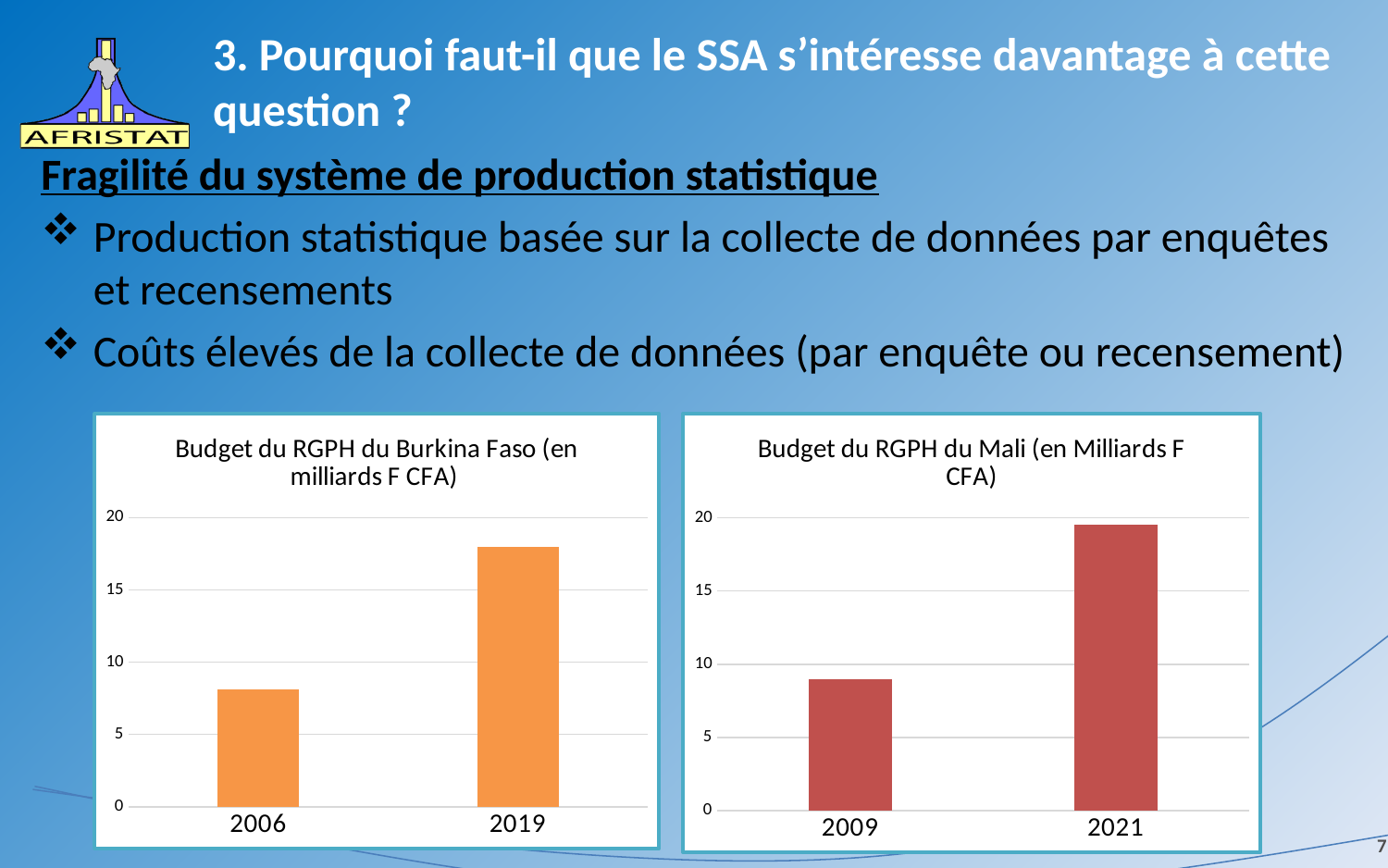
In the chart titled "Budget du RGPH du Mali (en Milliards F CFA)", which year has the highest value? 2021 In the chart titled "Budget du RGPH du Burkina Faso (en milliards F CFA)", is the value for 2019 greater or less than 15? greater What is the title of the chart on the left of the slide? Budget du RGPH du Burkina Faso (en milliards F CFA) In the chart titled "Budget du RGPH du Mali (en Milliards F CFA)", do the values rise or fall from 2009 to 2021? Rise In the chart titled "Budget du RGPH du Mali (en Milliards F CFA)", which is larger, the value for 2009 or the value for 2021? 2021 How many categories are shown in the chart titled "Budget du RGPH du Burkina Faso (en milliards F CFA)"? 2 In the chart titled "Budget du RGPH du Burkina Faso (en milliards F CFA)", which year has the highest value? 2019 In the chart titled "Budget du RGPH du Mali (en Milliards F CFA)", is the value for 2021 greater or less than 15? greater In the chart titled "Budget du RGPH du Mali (en Milliards F CFA)", is the value for 2009 greater or less than 10? less In the chart titled "Budget du RGPH du Burkina Faso (en milliards F CFA)", which year has the lowest value? 2006 What kind of chart is the chart on the right of the slide? Bar chart